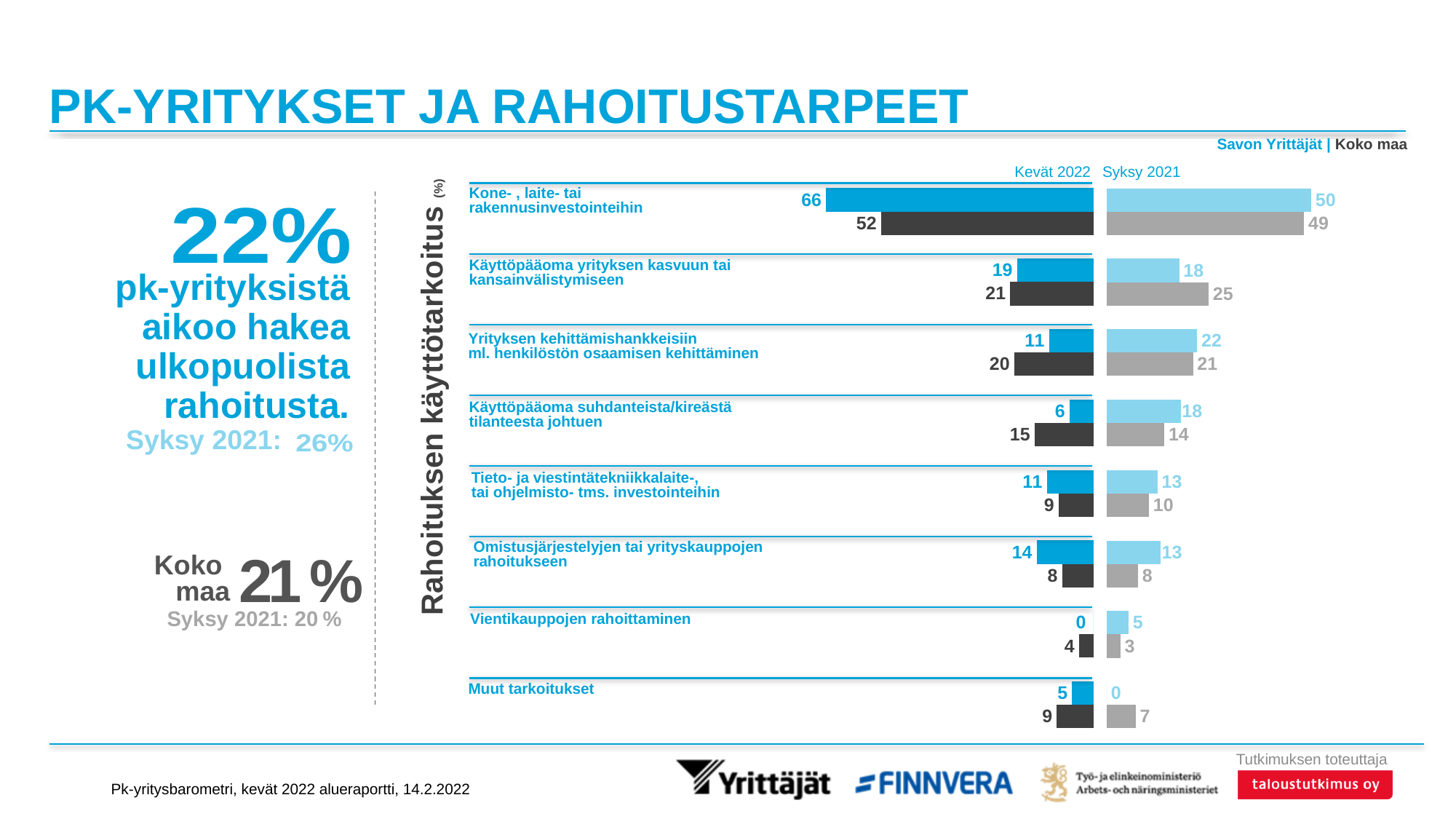
What is the difference between the Syksy 2021 and Kevät 2022 Savon Yrittäjät values for 'Käyttöpääoma suhdanteista/kireästä tilanteesta johtuen'? 12 Which two time periods are shown as column headings above the chart? Kevät 2022 and Syksy 2021 What kind of chart is shown on the slide? bar chart Which category has the highest Kevät 2022 value for Savon Yrittäjät? Kone-, laite- tai rakennusinvestointeihin Which category has the lowest Kevät 2022 value for Savon Yrittäjät? Vientikauppojen rahoittaminen For 'Omistusjärjestelyjen tai yrityskauppojen rahoitukseen' in Kevät 2022, which is larger: Savon Yrittäjät or Koko maa? Savon Yrittäjät How many financing purpose categories are listed in the chart? 8 What is the Kevät 2022 value for Savon Yrittäjät for 'Kone-, laite- tai rakennusinvestointeihin'? 66 What is the Syksy 2021 value for Koko maa for 'Käyttöpääoma yrityksen kasvuun tai kansainvälistymiseen'? 25 What is the Kevät 2022 value for Koko maa for 'Käyttöpääoma suhdanteista/kireästä tilanteesta johtuen'? 15 What is the difference between the Savon Yrittäjät and Koko maa Kevät 2022 values for 'Kone-, laite- tai rakennusinvestointeihin'? 14 What is the Syksy 2021 value for Savon Yrittäjät for 'Yrityksen kehittämishankkeisiin ml. henkilöstön osaamisen kehittäminen'? 22